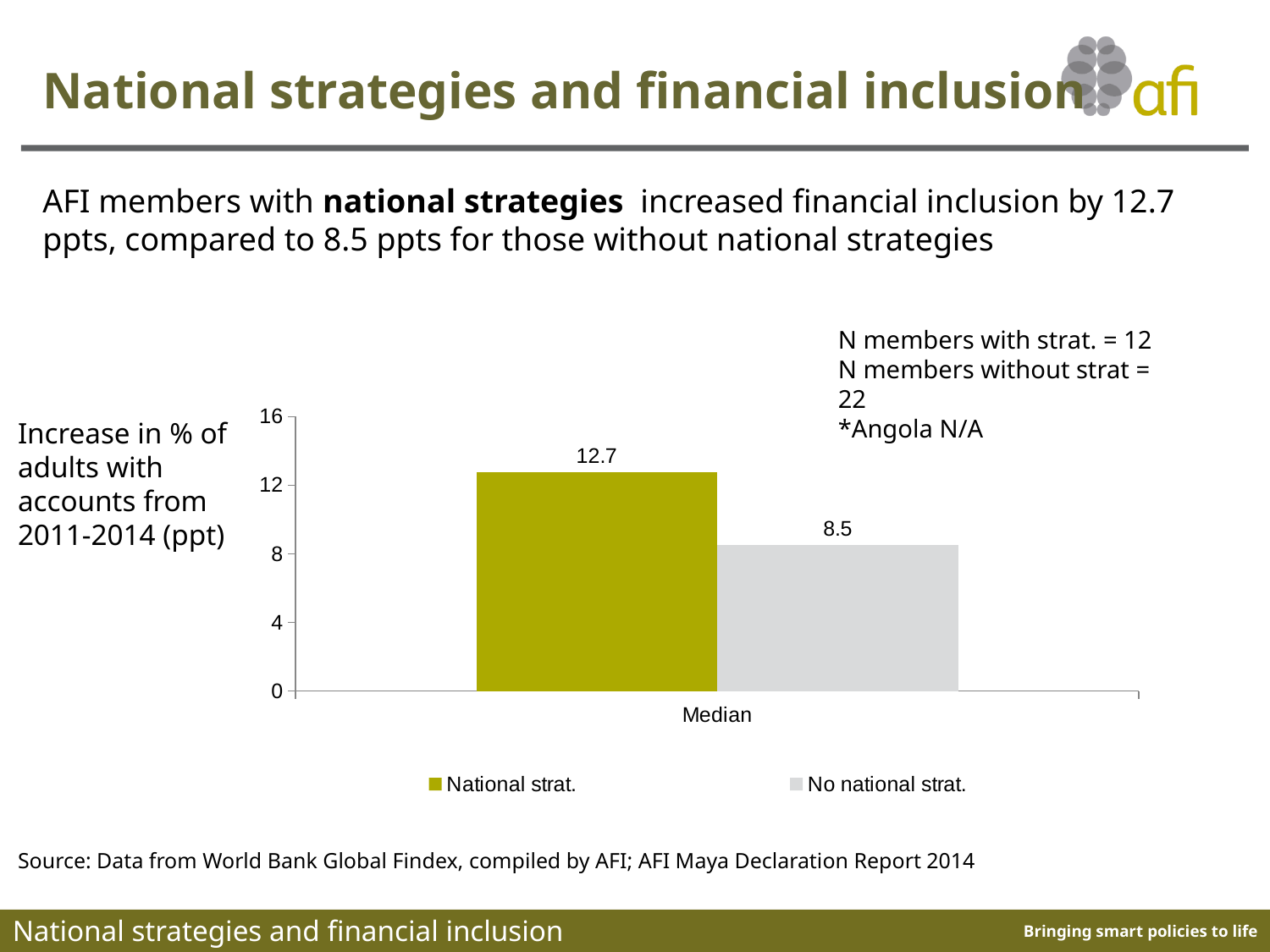
Which series has the higher value in the chart? National strat. Is the value for No national strat. greater or less than 12? less What colour is the bar for National strat.? olive green What is the difference between the National strat. and No national strat. values? 4.2 What is the value for No national strat. in the chart? 8.5 What kind of chart is shown on the slide? bar chart Which series has the lower value in the chart? No national strat. Is the value for National strat. larger or smaller than the value for No national strat.? larger How many series does the legend list? 2 What is the category label on the x axis of the chart? Median What is the value for National strat. in the chart? 12.7 Is the value for National strat. greater or less than 12? greater